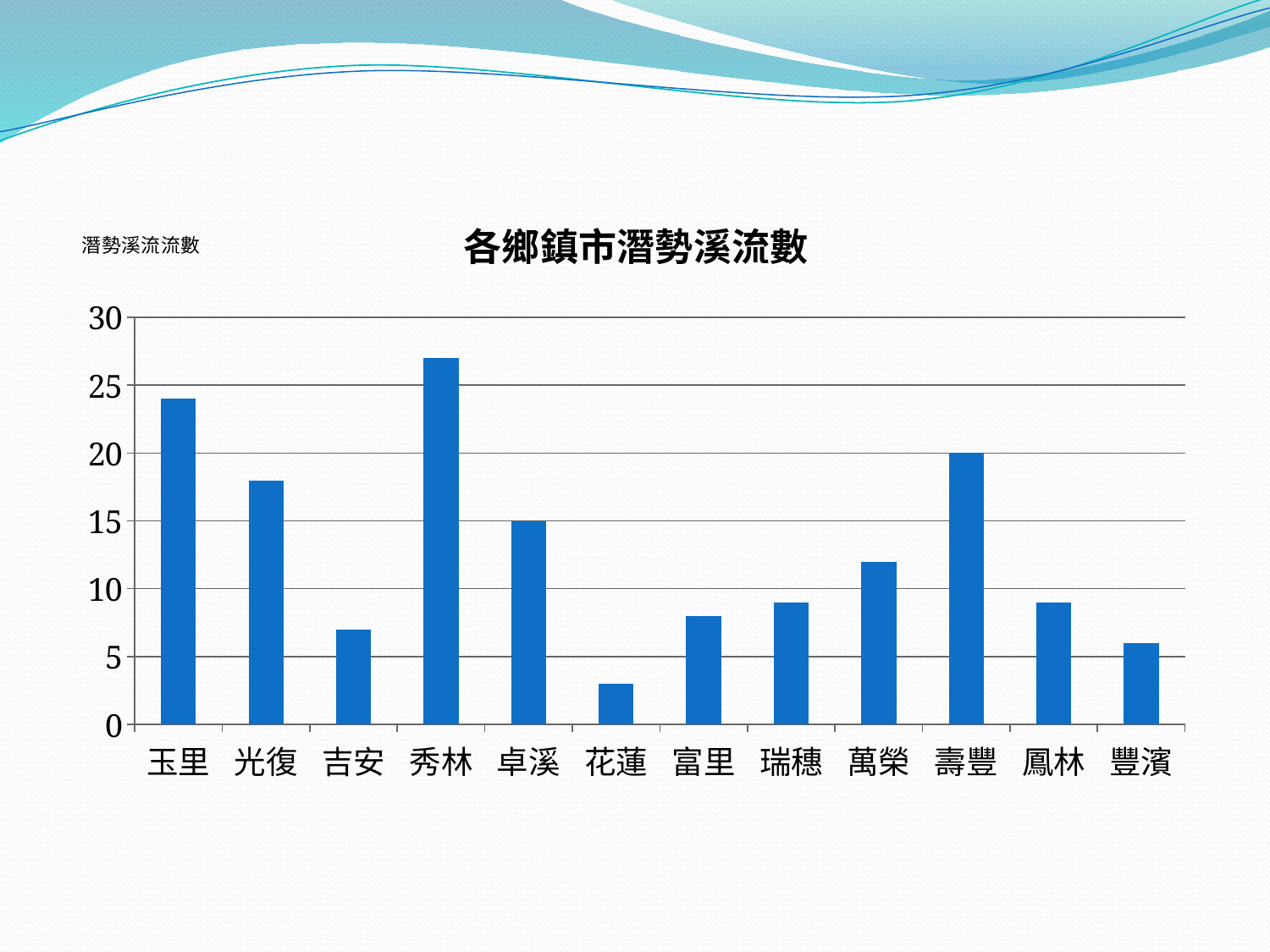
How many townships (categories) are shown on the x axis? 12 Which is larger, the value for 玉里 or the value for 光復? 玉里 What is the value for 卓溪? 15 What is the value for 壽豐? 20 What is the label on the vertical axis of the chart? 潛勢溪流流數 What type of chart is shown on the slide? bar chart Is the value for 吉安 greater or less than 10? less Which township has the highest number of potential debris-flow streams? 秀林 What is the difference between the values for 壽豐 and 卓溪? 5 Is the value for 玉里 greater or less than 20? greater Which township has the lowest number of potential debris-flow streams? 花蓮 What is the title of the chart? 各鄉鎮市潛勢溪流數